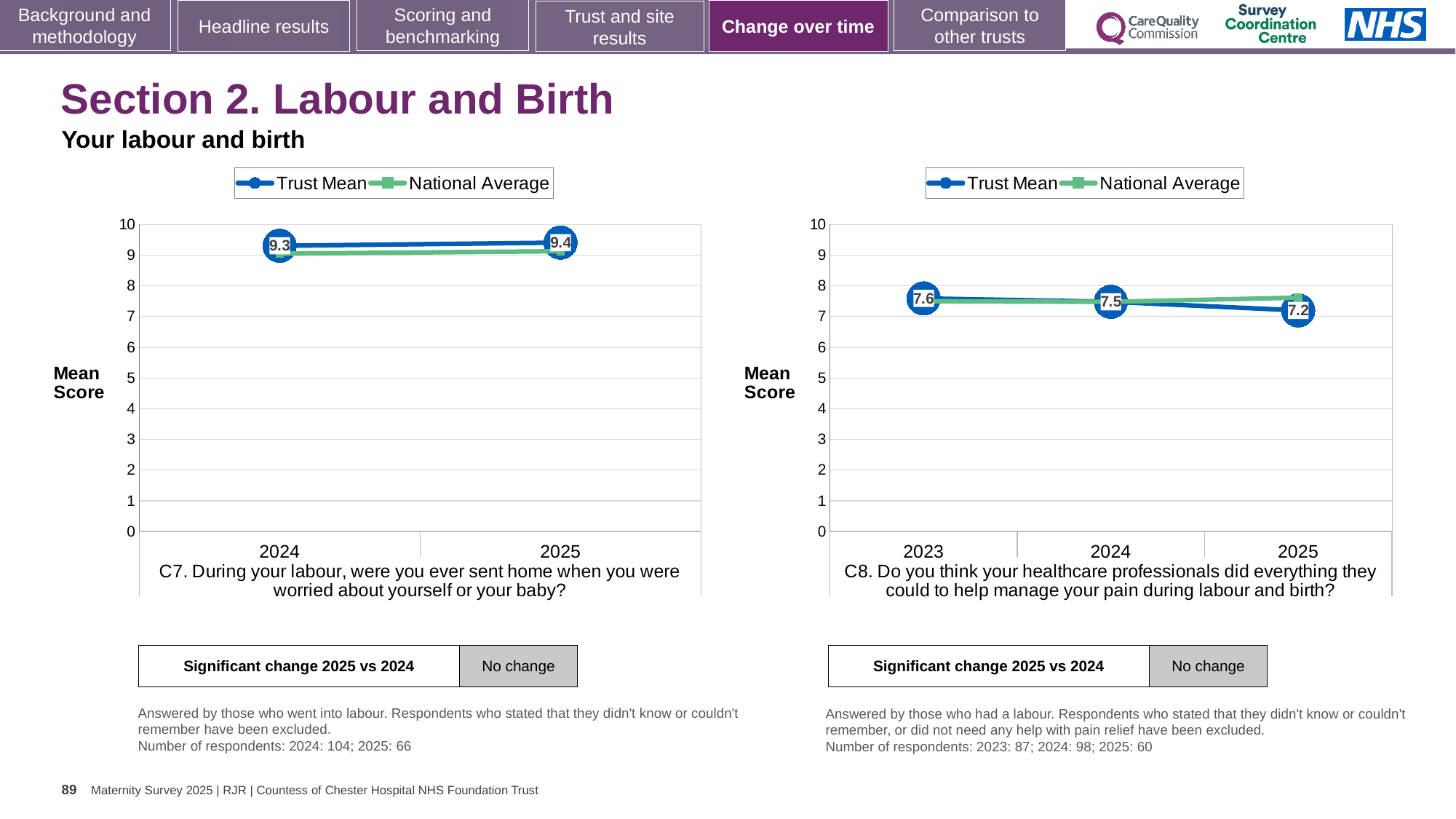
In the C8 chart (right), which year has the highest Trust Mean? 2023 How many years are plotted on the x axis of the C8 chart (right)? 3 In the C7 chart (left), what is the Trust Mean for 2025? 9.4 In the C8 chart (right), what is the difference between the Trust Mean for 2023 and 2025? 0.4 In the C8 chart (right), what is the Trust Mean for 2023? 7.6 How many series does the legend of the C7 chart (left) list? 2 In the C8 chart (right), which year has the lowest Trust Mean? 2025 In the C7 chart (left), what is the Trust Mean for 2024? 9.3 In the C8 chart (right), does the Trust Mean rise or fall from 2023 to 2025? fall In the C7 chart (left), does the Trust Mean rise or fall from 2024 to 2025? rise In the C8 chart (right), what is the Trust Mean for 2025? 7.2 What type of chart is the C7 chart (left)? line chart